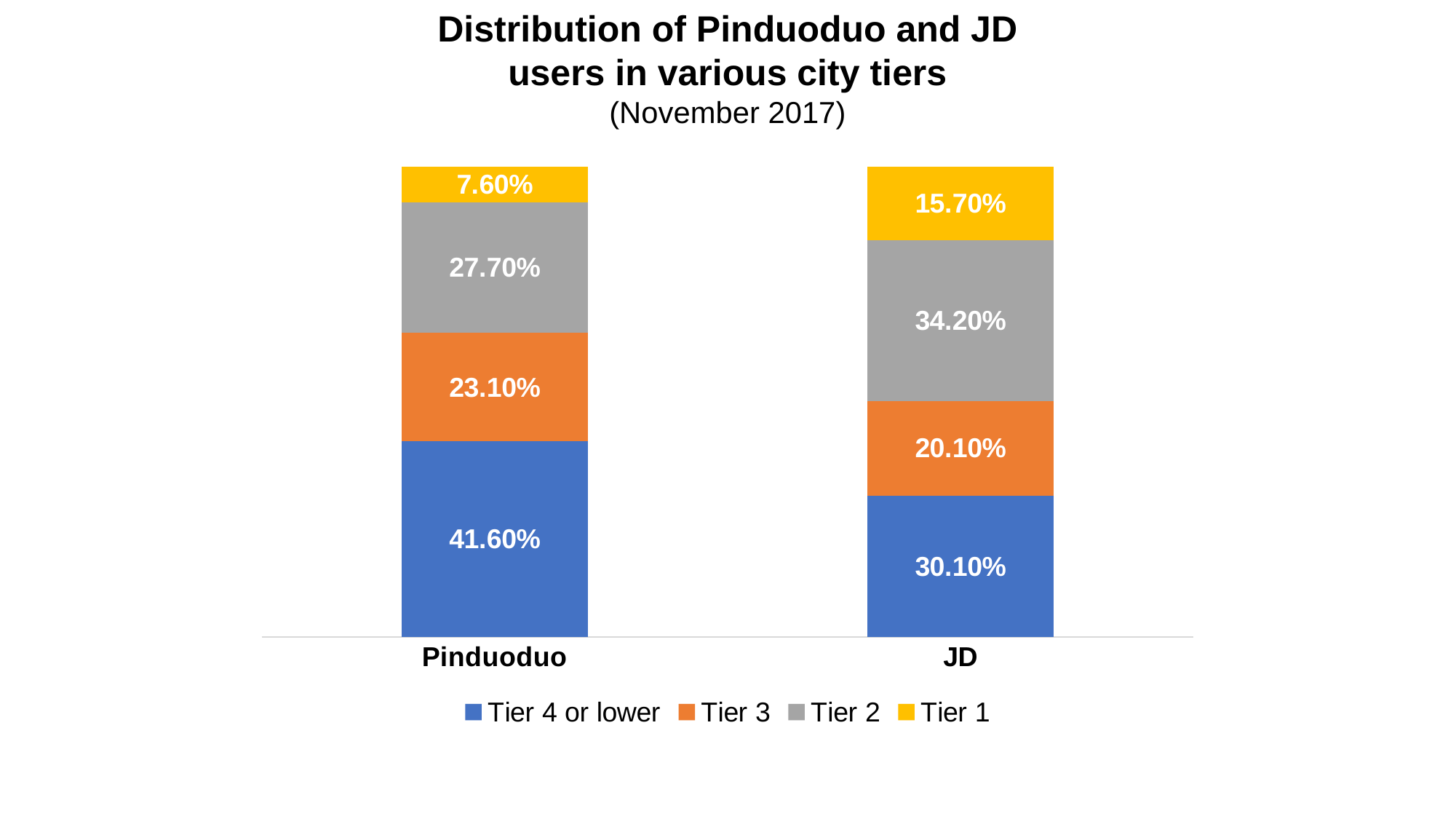
Which tier is the smallest segment of the Pinduoduo bar? Tier 1 Which platform has the larger share of Tier 4 or lower users, Pinduoduo or JD? Pinduoduo How many series does the legend list? 4 What kind of chart is shown on the slide? Stacked bar chart What is the Tier 2 value for JD? 34.20% Which tier is the largest segment of the JD bar? Tier 2 What share of Pinduoduo users are in Tier 4 or lower cities? 41.60% What is the difference between the Tier 1 shares of JD and Pinduoduo? 8.10 percentage points What is the Tier 3 value for Pinduoduo? 23.10% What share of JD users are in Tier 1 cities? 15.70% What is the difference between the Tier 4 or lower shares of Pinduoduo and JD? 11.50 percentage points Which platform has the larger share of Tier 1 users, Pinduoduo or JD? JD